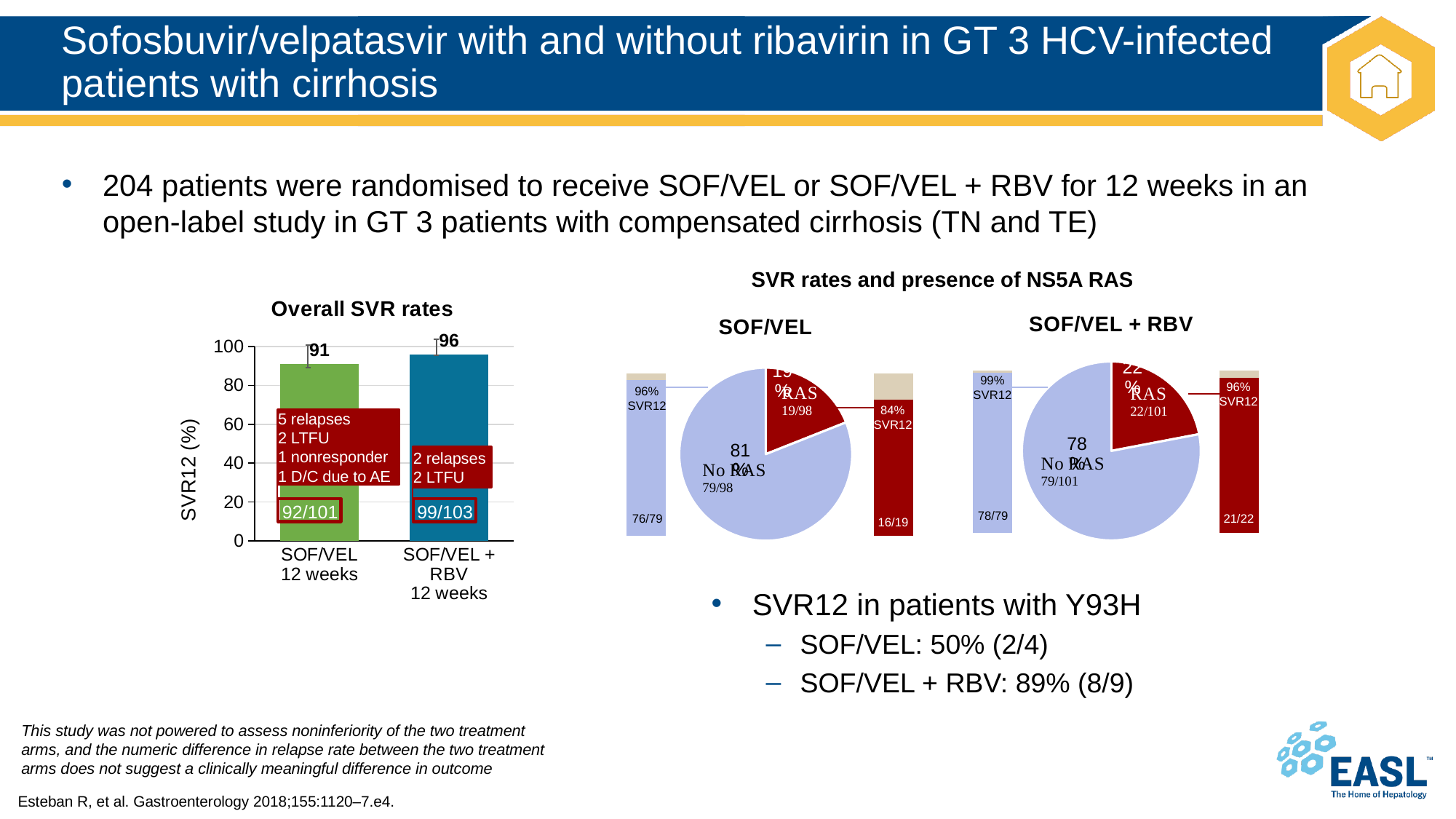
In the 'SVR rates and presence of NS5A RAS' section, what was the SVR12 rate for SOF/VEL patients with RAS? 84% In the 'Overall SVR rates' chart, which treatment arm has the higher SVR12 rate? SOF/VEL + RBV 12 weeks In the SOF/VEL + RBV pie chart under 'SVR rates and presence of NS5A RAS', what share of patients had RAS? 22% In the 'Overall SVR rates' chart, how many treatment arms are plotted? 2 In the 'Overall SVR rates' chart, what is the SVR12 value for SOF/VEL 12 weeks? 91 What kind of chart is the 'Overall SVR rates' chart? Bar chart In the 'Overall SVR rates' chart, what is the label on the y axis? SVR12 (%) In the 'Overall SVR rates' chart, what fraction of patients achieved SVR12 in the SOF/VEL + RBV 12 weeks arm? 99/103 In the 'Overall SVR rates' chart, what is the difference in SVR12 between SOF/VEL + RBV 12 weeks and SOF/VEL 12 weeks? 5 In the 'Overall SVR rates' chart, what is the SVR12 value for SOF/VEL + RBV 12 weeks? 96 In the SOF/VEL pie chart under 'SVR rates and presence of NS5A RAS', what share of patients had no RAS? 81% In the SOF/VEL + RBV pie chart, which slice is larger, No RAS or RAS? No RAS